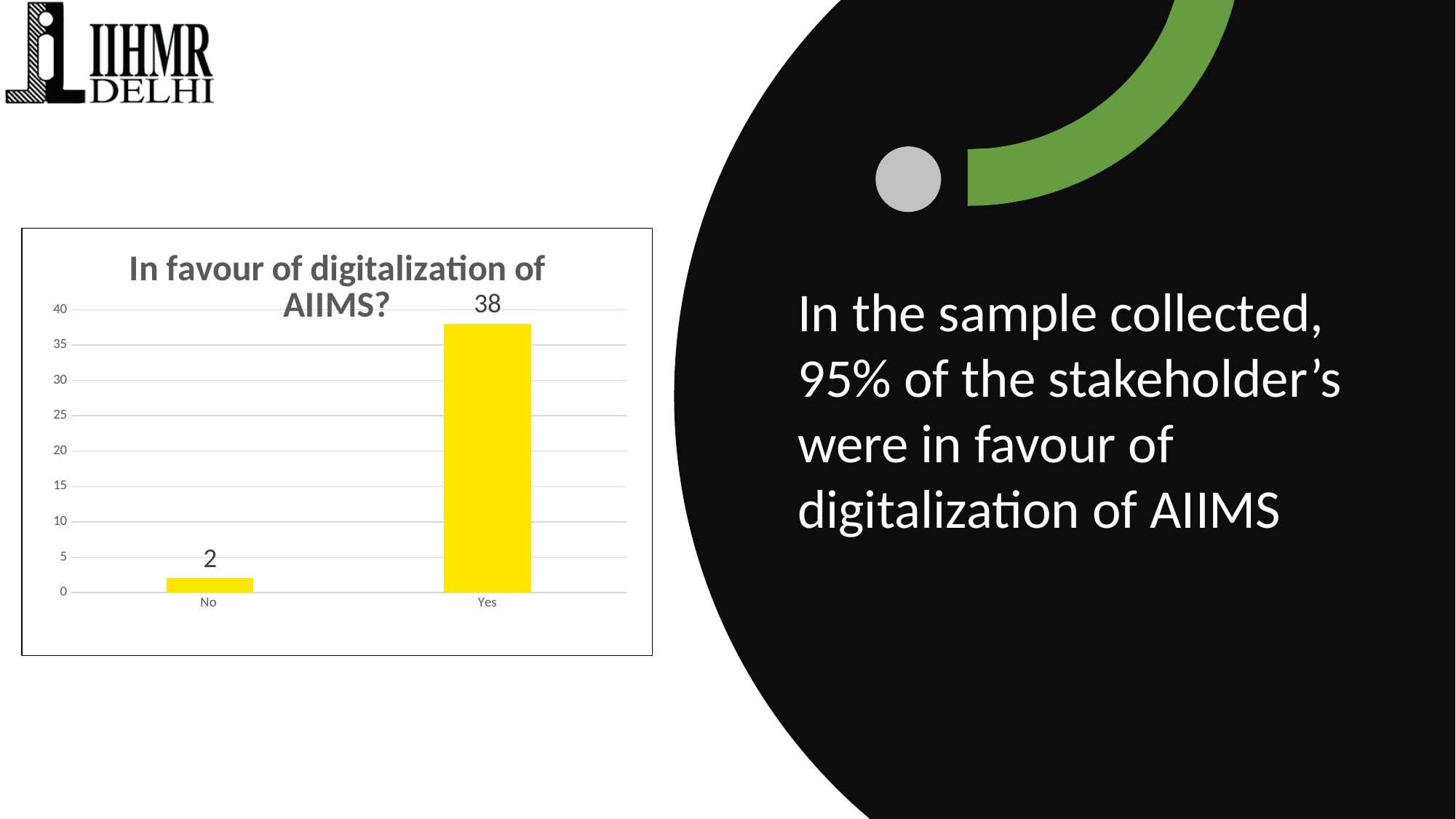
What kind of chart is shown on the slide? bar chart What colour are the bars in the chart? yellow What is the title of the chart? In favour of digitalization of AIIMS? What is the value for No? 2 How many categories are shown on the x axis? 2 Is the value for No greater or less than 5? less What is the value for Yes? 38 Which is larger, the value for Yes or the value for No? Yes Which category has the lowest value? No What is the difference between the values for Yes and No? 36 Is the value for Yes greater or less than 35? greater Which category has the highest value? Yes